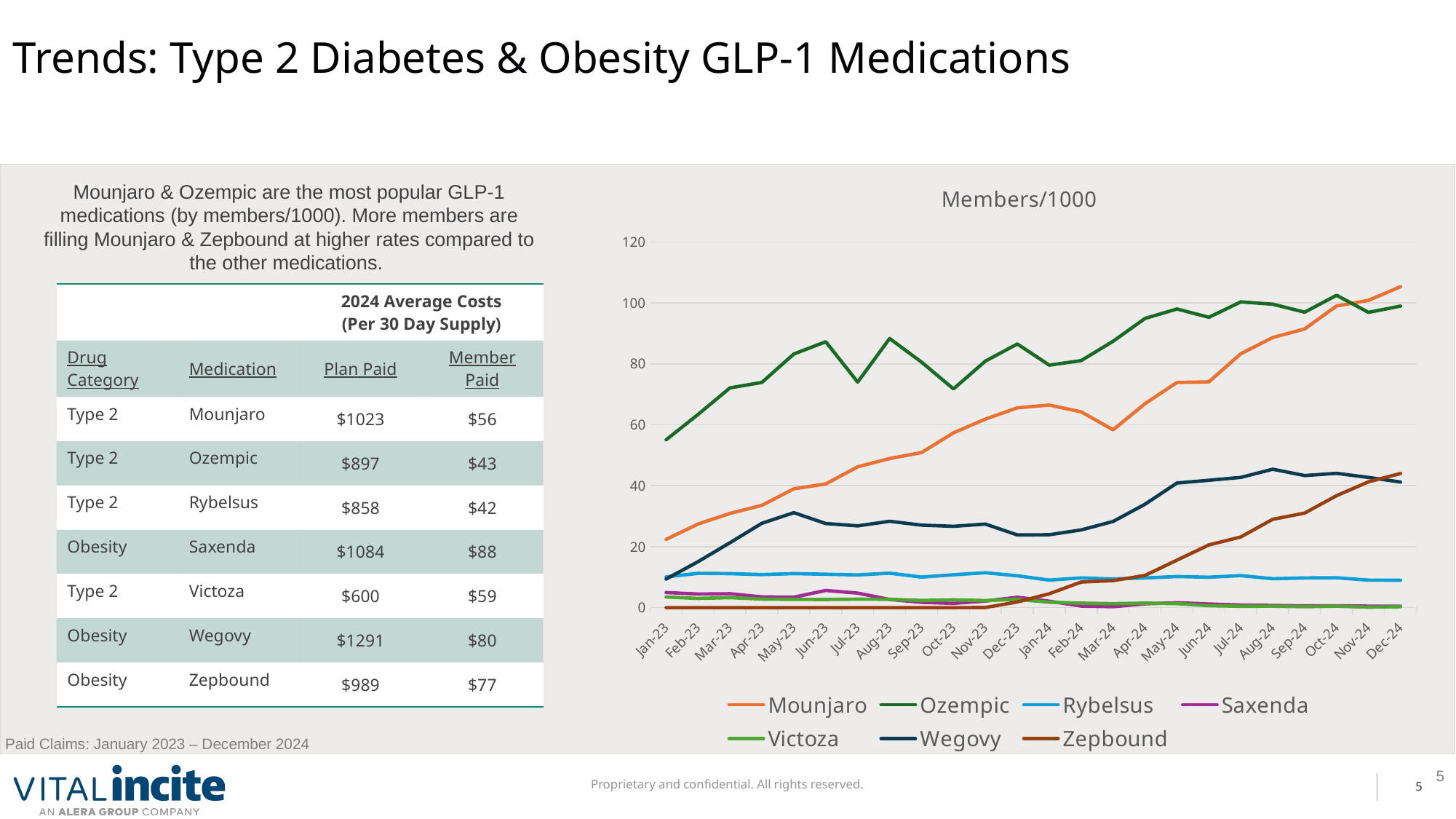
Does the Mounjaro line generally rise or fall from Jan-23 to Dec-24? rise Which series has the highest value in Jan-23? Ozempic Is the value for Wegovy in Aug-24 greater or less than 40? greater Is the value for Ozempic in Jan-23 greater or less than 60? less In Jan-23, which is larger: Ozempic or Mounjaro? Ozempic What kind of chart is the Members/1000 chart? line chart In Dec-24, which is larger: Wegovy or Rybelsus? Wegovy Is the value for Zepbound in Jan-23 greater or less than 20? less How many series does the legend of the Members/1000 chart list? 7 How many months are shown along the x axis of the Members/1000 chart? 24 What is the title of the chart on the slide? Members/1000